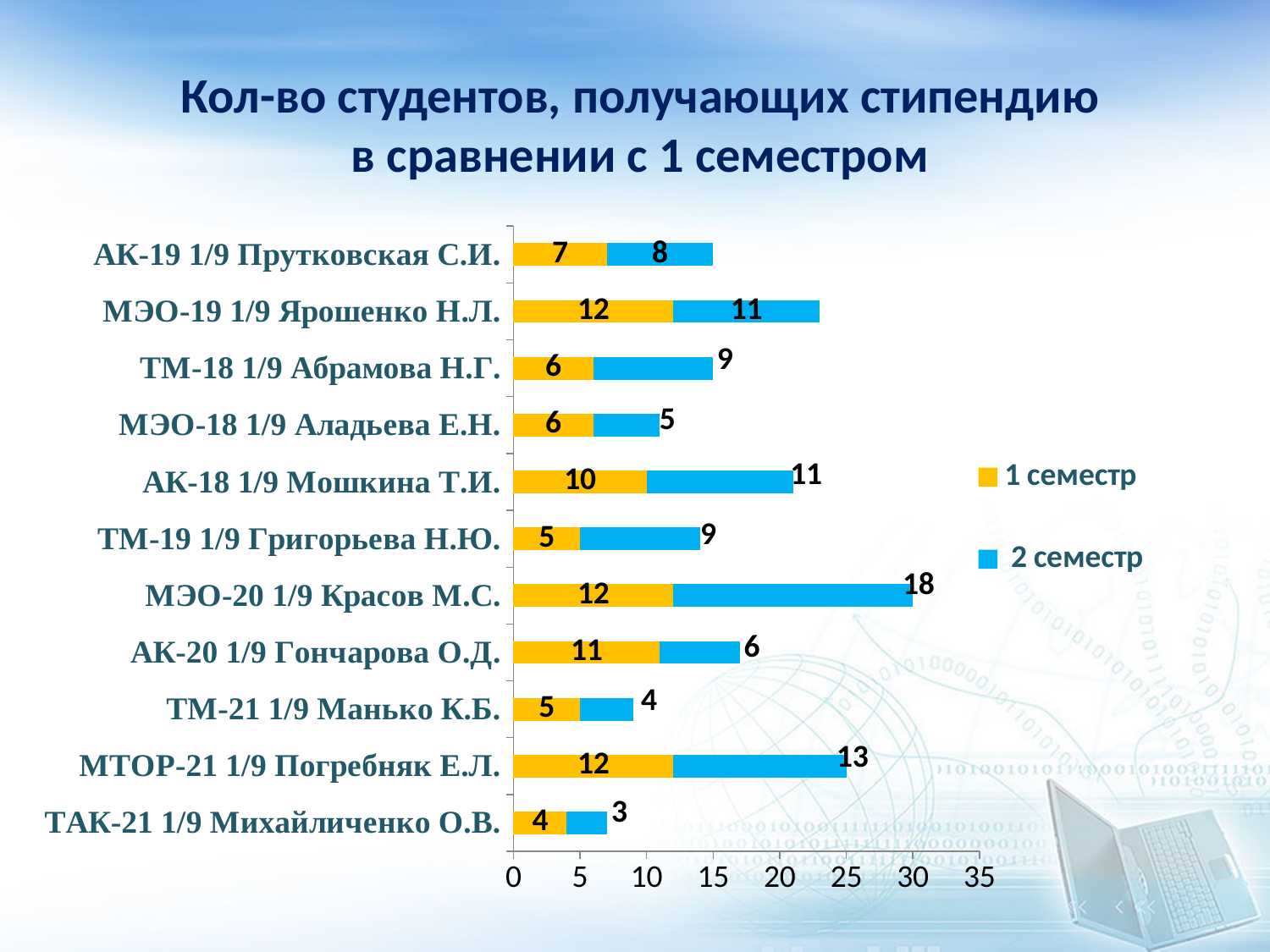
Which colour represents 1 семестр in the legend? yellow Which group has the highest value for 2 семестр? МЭО-20 1/9 Красов М.С. What is the difference between the 2 семестр and 1 семестр values for ТМ-19 1/9 Григорьева Н.Ю.? 4 Which group has the lowest value for 2 семестр? ТАК-21 1/9 Михайличенко О.В. What is the value for 1 семестр for АК-18 1/9 Мошкина Т.И.? 10 Is the total of the stacked bar for МЭО-19 1/9 Ярошенко Н.Л. greater or less than 20? greater What is the total of the stacked bar for МТОР-21 1/9 Погребняк Е.Л.? 25 How many groups (categories) are shown on the chart? 11 Which is larger for АК-20 1/9 Гончарова О.Д.: the 1 семестр value or the 2 семестр value? 1 семестр What type of chart is shown on the slide? bar chart What is the value for 2 семестр for МЭО-20 1/9 Красов М.С.? 18 How many series does the legend list? 2